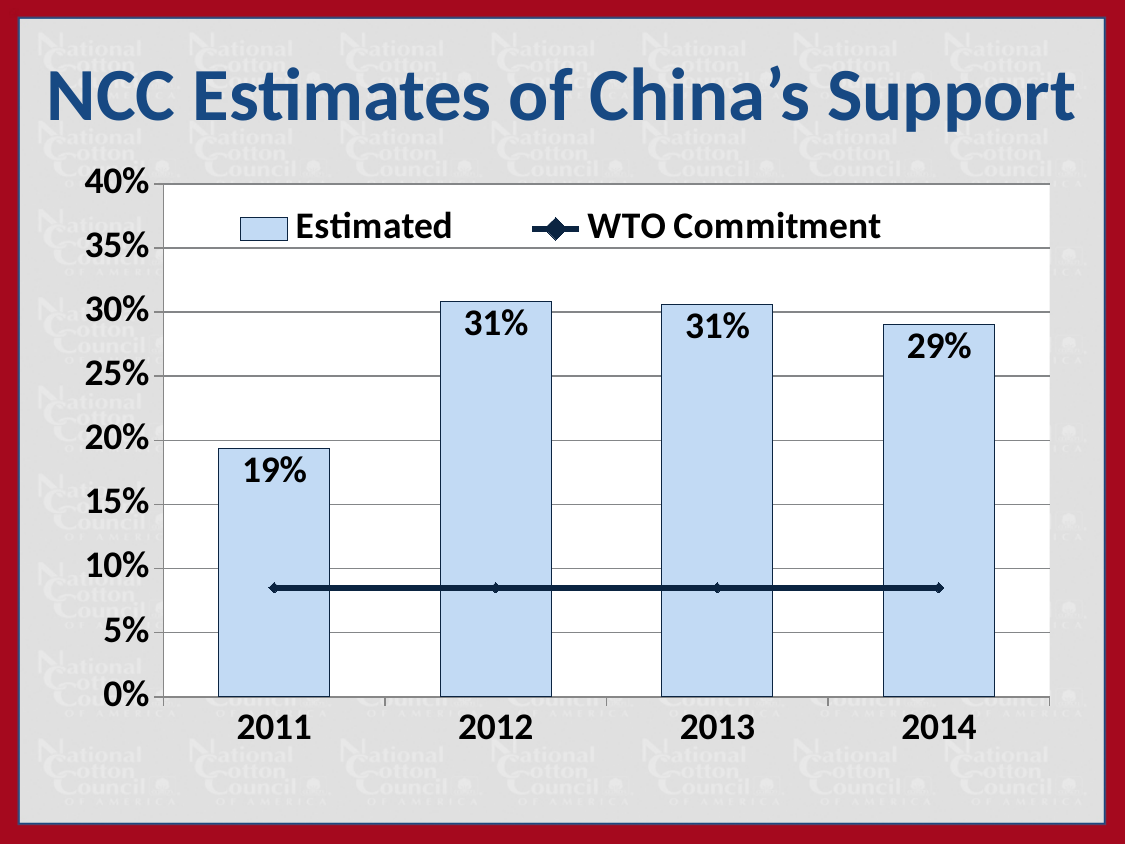
Is the WTO Commitment value greater or less than 10%? less How many years are shown on the x axis? 4 What is the title of the chart? NCC Estimates of China's Support Which year has the lowest Estimated value? 2011 What kind of chart is used to show the Estimated values? bar chart What is the Estimated value for 2012? 31% What is the Estimated value for 2011? 19% What is the Estimated value for 2014? 29% How many series does the legend list? 2 What is the difference between the Estimated values for 2012 and 2011? 12 percentage points Which is larger, the Estimated value for 2011 or for 2014? 2014 What is the difference between the Estimated values for 2013 and 2014? 2 percentage points